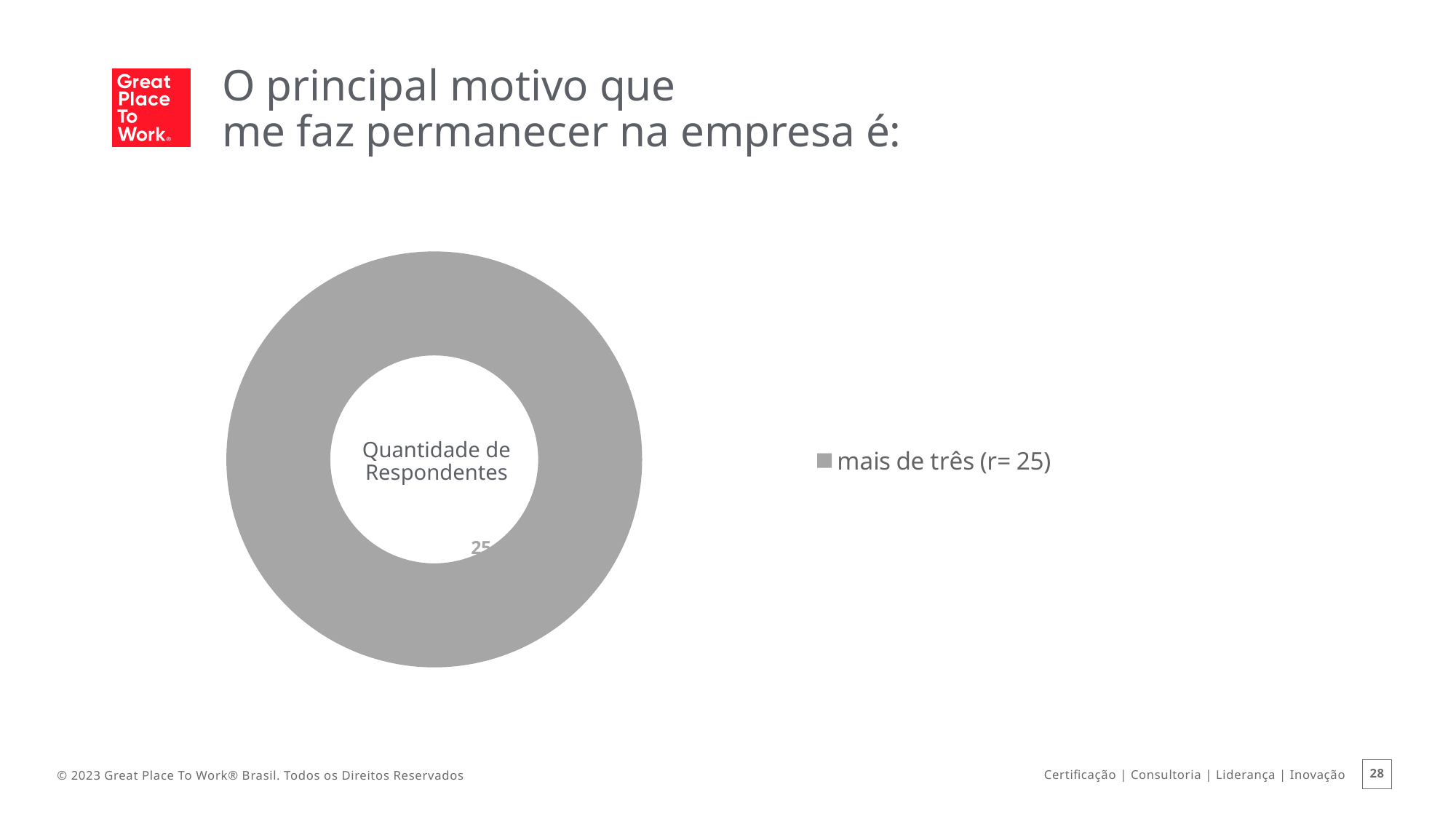
Is the value for "mais de três (r= 25)" greater or less than 20? greater How many entries does the chart legend list? 1 What kind of chart is shown on the slide? Doughnut chart How many slices does the doughnut chart have? 1 What value is shown for the slice "mais de três (r= 25)"? 25 What is the only entry listed in the chart legend? mais de três (r= 25) What share of the doughnut does the slice "mais de três (r= 25)" represent? 100% What text appears in the centre of the doughnut chart? Quantidade de Respondentes